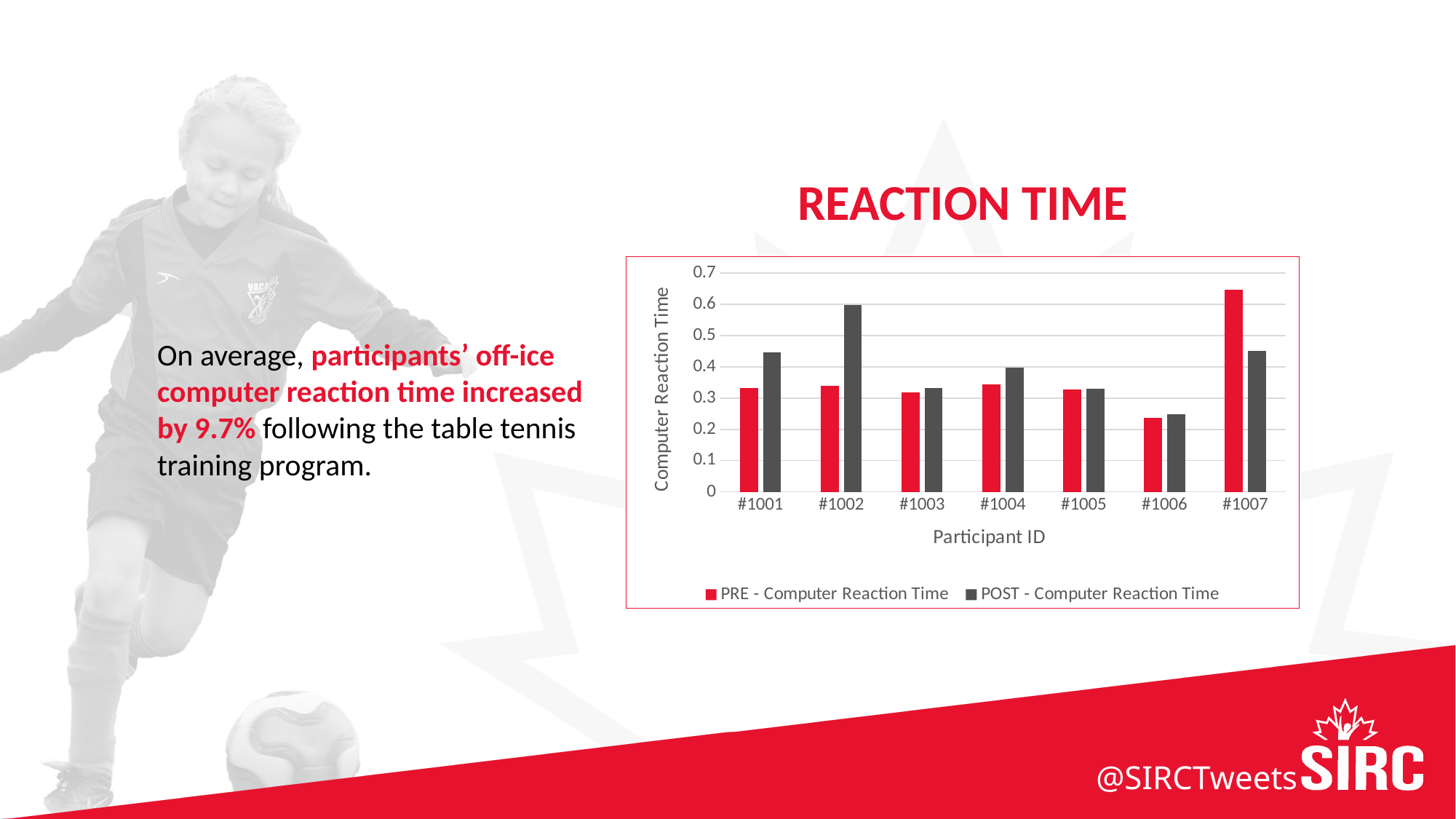
Which participant has the lowest PRE - Computer Reaction Time? #1006 Is the PRE - Computer Reaction Time for participant #1007 greater or less than 0.6? greater How many participant IDs are shown on the x axis of the chart? 7 For participant #1002, which is larger: the PRE or the POST computer reaction time? POST Which participant has the highest PRE - Computer Reaction Time? #1007 Is the PRE - Computer Reaction Time for participant #1006 greater or less than 0.3? less What is the title of the chart's y axis? Computer Reaction Time Which participant has the lowest POST - Computer Reaction Time? #1006 How many series does the chart legend list? 2 Which participant has the highest POST - Computer Reaction Time? #1002 What kind of chart is shown on the slide? bar chart For participant #1007, which is larger: the PRE or the POST computer reaction time? PRE